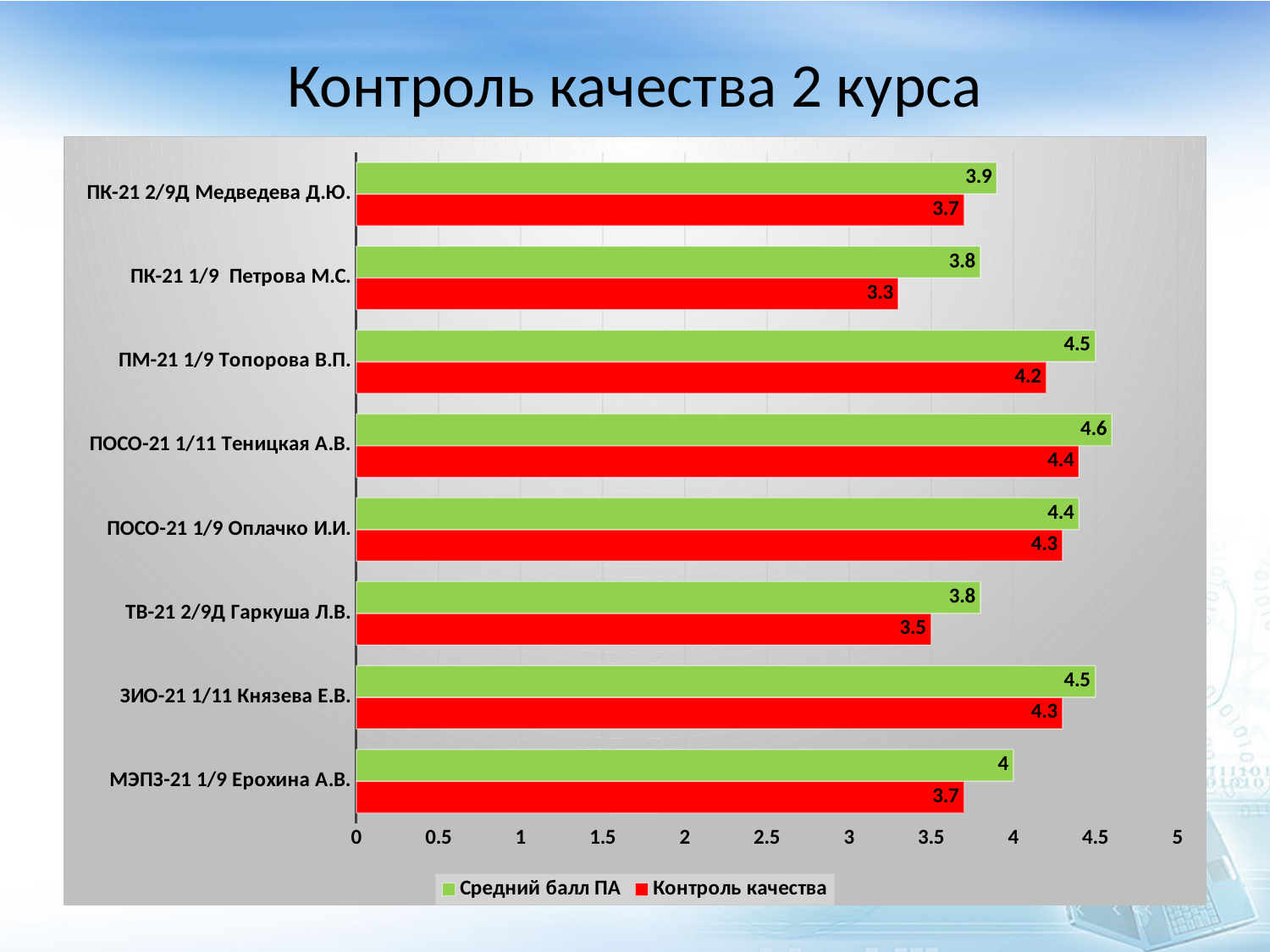
Which is larger: the Контроль качества value for ПМ-21 1/9 Топорова В.П. or for ТВ-21 2/9Д Гаркуша Л.В.? ПМ-21 1/9 Топорова В.П. Which category has the highest Средний балл ПА value? ПОСО-21 1/11 Теницкая А.В. Which category has the highest Контроль качества value? ПОСО-21 1/11 Теницкая А.В. What is the difference between the Средний балл ПА and Контроль качества values for ПК-21 1/9 Петрова М.С.? 0.5 Which category has the lowest Контроль качества value? ПК-21 1/9 Петрова М.С. What is the Контроль качества value for ЗИО-21 1/11 Князева Е.В.? 4.3 What is the Средний балл ПА value for ПОСО-21 1/11 Теницкая А.В.? 4.6 What type of chart is shown on the slide? Bar chart How many categories are shown on the chart? 8 Is the Средний балл ПА value for МЭПЗ-21 1/9 Ерохина А.В. greater or less than 3.5? greater What is the Контроль качества value for ПК-21 1/9 Петрова М.С.? 3.3 How many series does the legend list? 2